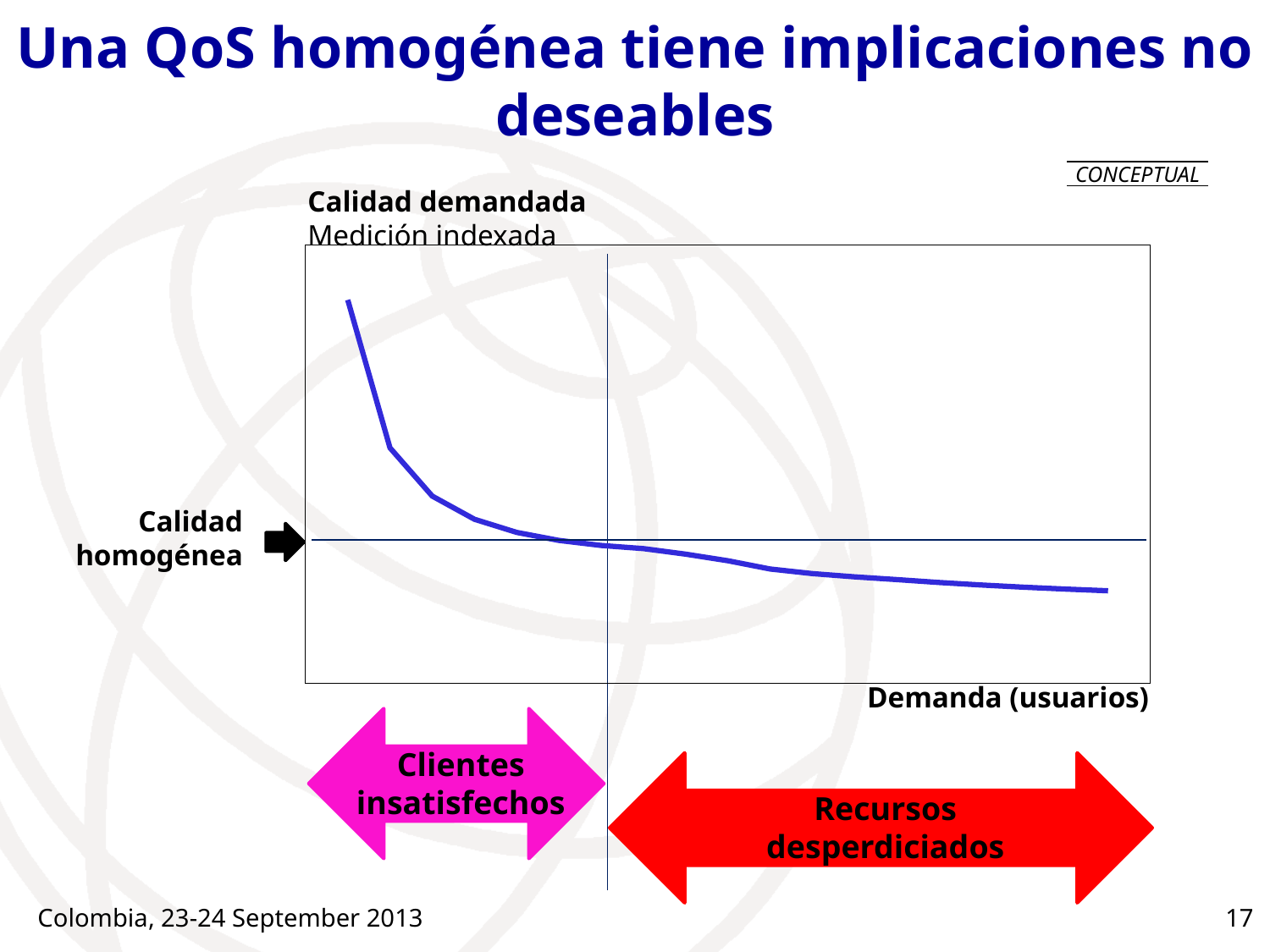
What label is given to the horizontal reference line on the chart? Calidad homogénea How many data series are plotted on the chart? 1 What kind of chart is shown on the slide? line chart Does the plotted line rise or fall as demand (Demanda) increases along the x axis? fall What is the label of the x axis of the chart? Demanda (usuarios)